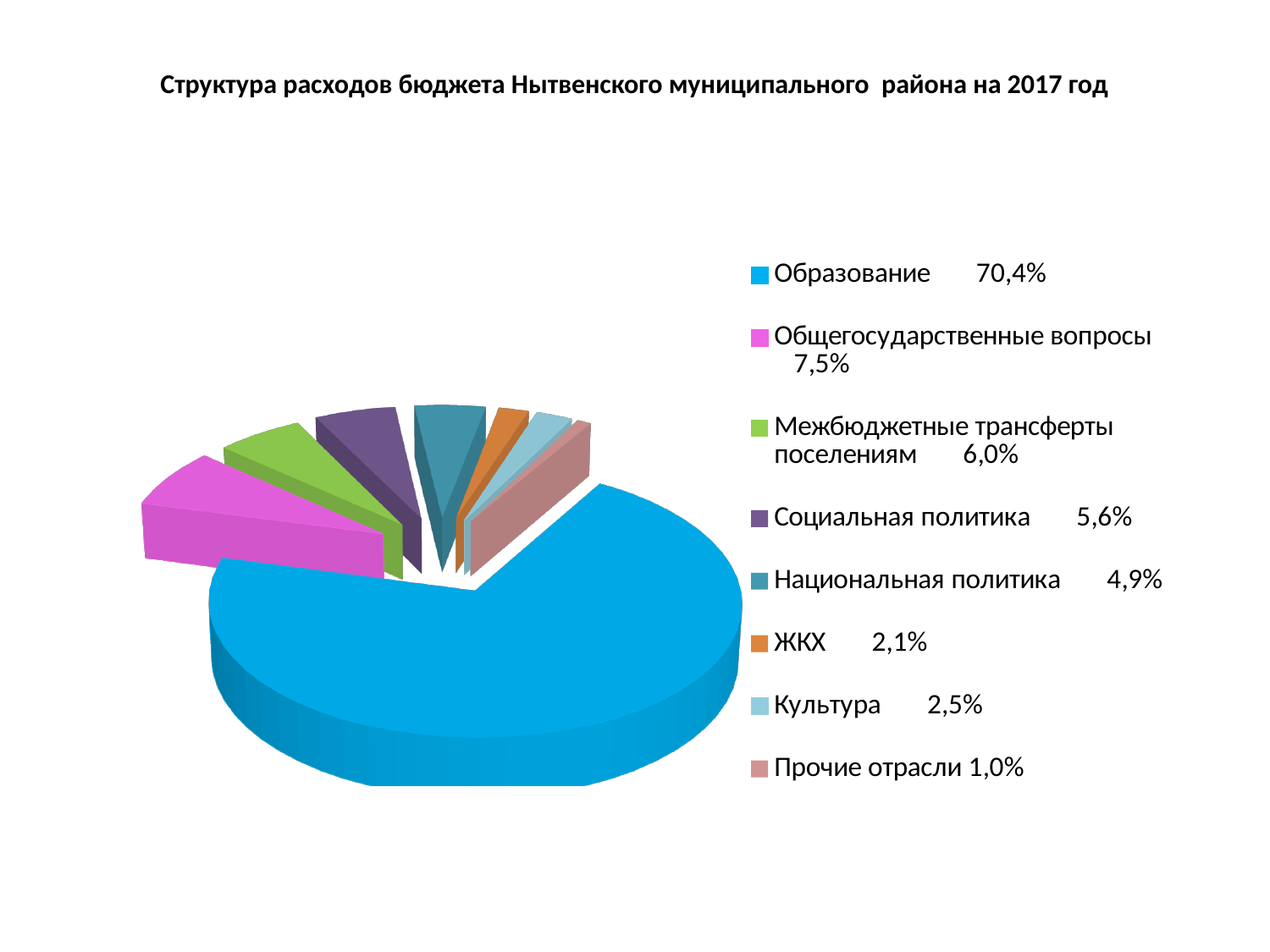
What is the value for ЖКХ? 2,1% Which category has the smallest share of the budget expenditure? Прочие отрасли Which is larger: Культура or ЖКХ? Культура What is the difference between the shares of Социальная политика and Национальная политика? 0,7% What type of chart is shown on the slide? Pie chart What is the value shown for Общегосударственные вопросы? 7,5% What percentage is shown for Межбюджетные трансферты поселениям? 6,0% Which category has the largest share of the budget expenditure? Образование What share of the budget expenditure goes to Образование? 70,4% How many categories does the pie chart show? 8 What colour is the slice for Общегосударственные вопросы? Pink (magenta) What is the title of the chart? Структура расходов бюджета Нытвенского муниципального района на 2017 год